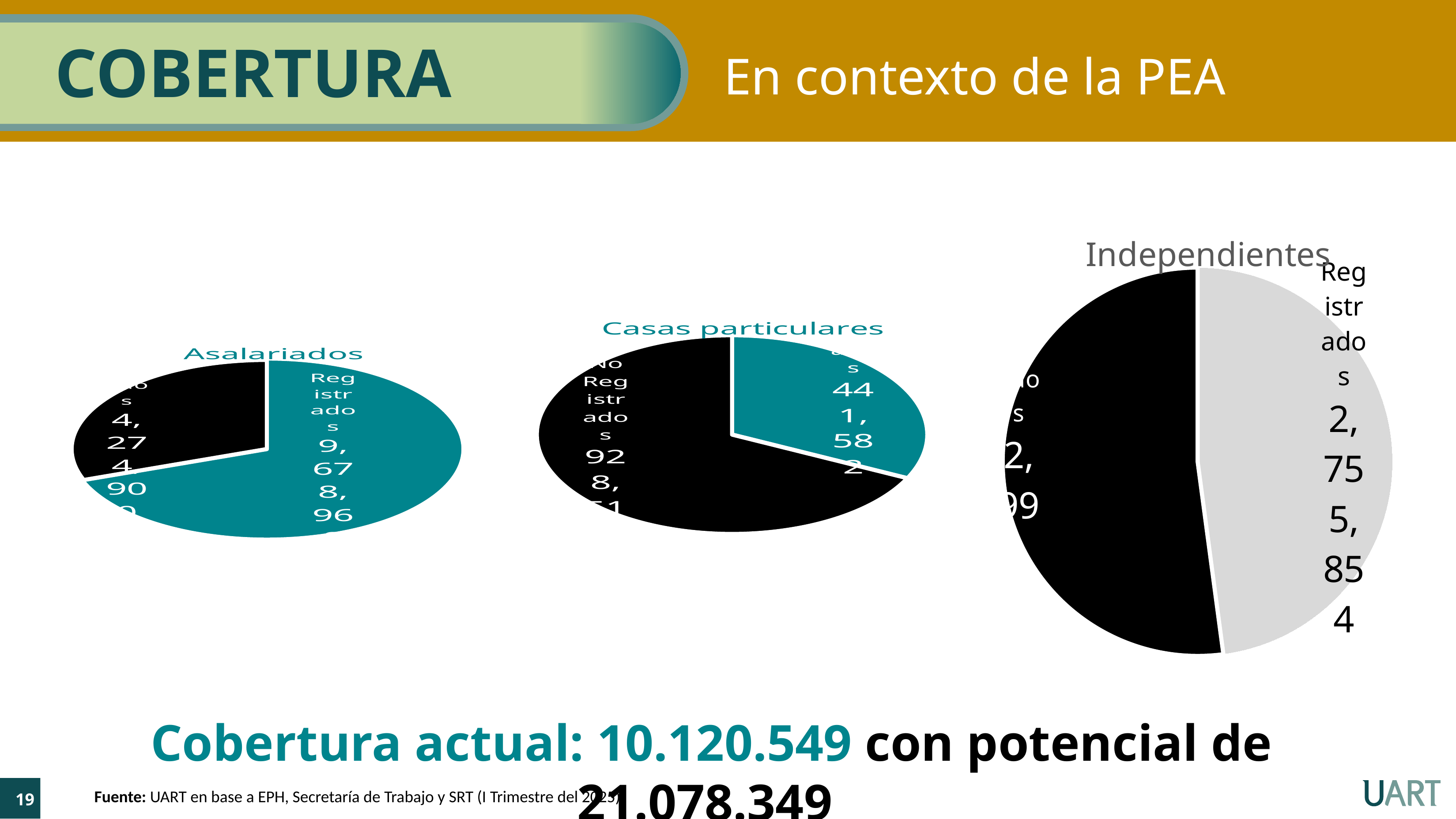
In the Casas particulares chart, what colour is the Registrados slice? teal In the Casas particulares chart, what is the value for Registrados? 441,582 What is the title of the rightmost pie chart? Independientes How many slices does the Casas particulares pie chart have? 2 In the Casas particulares chart, which category has the smallest slice? Registrados What kind of chart is the Asalariados chart? pie chart In the Asalariados chart, which slice is larger, Registrados or No Registrados? Registrados In the Casas particulares chart, which slice is larger, Registrados or No Registrados? No Registrados In the Asalariados chart, which category has the largest slice? Registrados In the Independientes chart, what is the value for Registrados? 2,755,854 How many pie charts are shown on the slide? 3